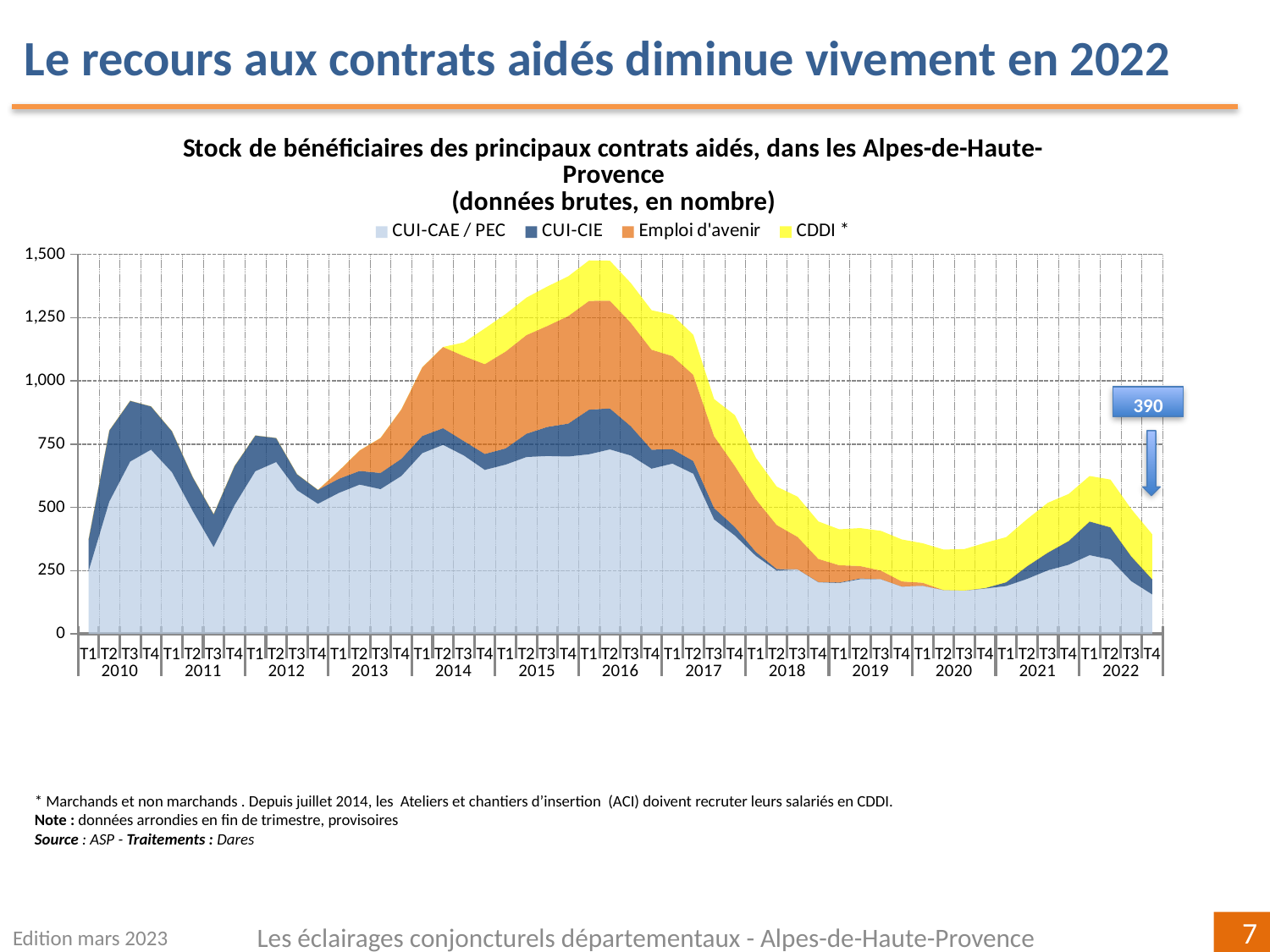
What kind of chart is shown on the slide? stacked area chart Do the total values rise or fall between T1 2016 and T4 2020? fall Is the total stock in T1 2010 greater or less than 500? less In which year does the total stock reach its highest peak? 2016 How many years are shown on the x axis? 13 How many series does the legend list? 4 Which series is shown in yellow? CDDI * Is the total stock in T4 2020 greater or less than 500? less Is the total stock in T1 2022 greater or less than 500? greater What total value is labelled for T4 2022? 390 Which is larger, the total stock in T1 2016 or in T4 2022? T1 2016